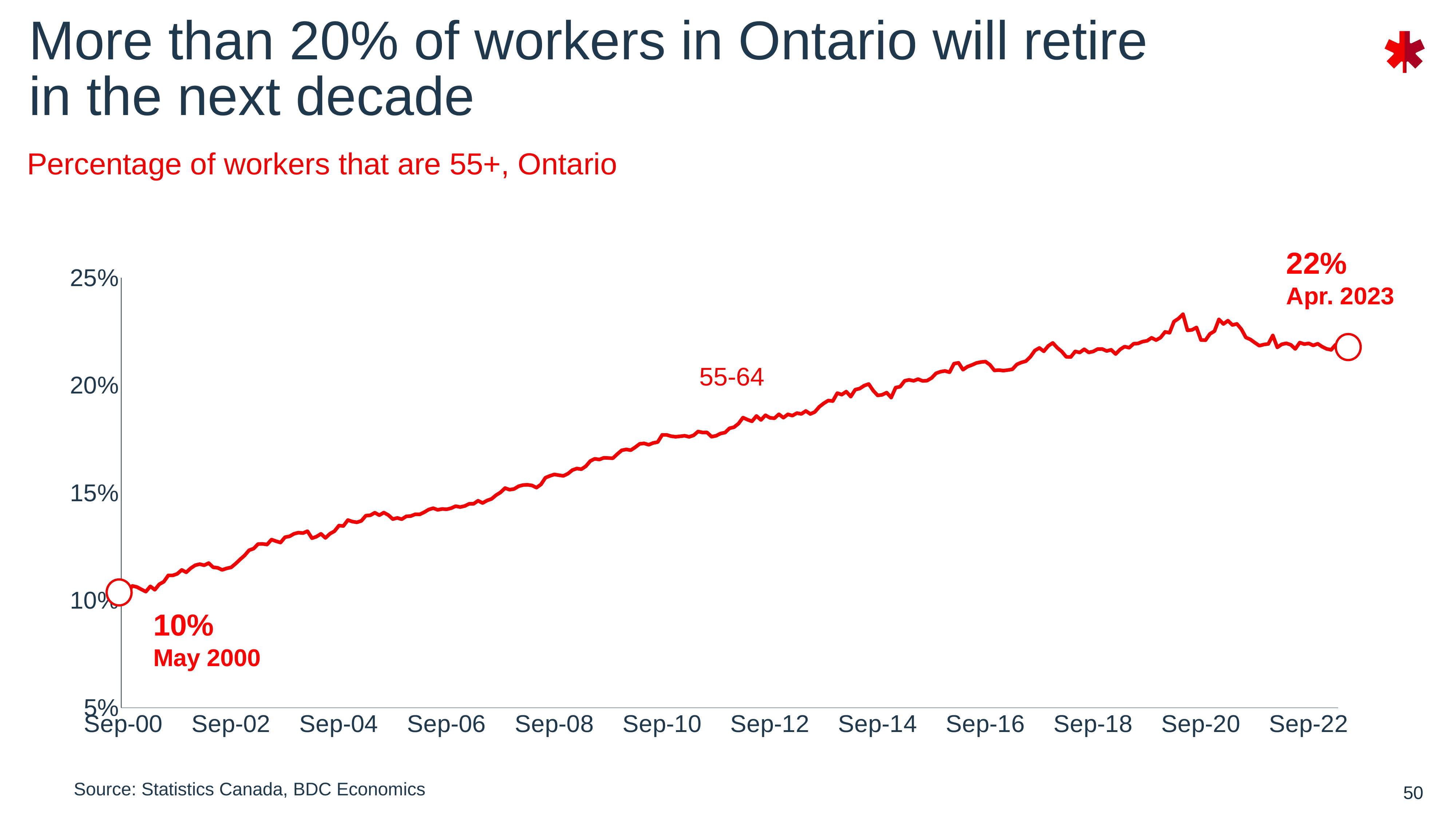
What is the percentage of workers that are 55+ in Ontario in Apr. 2023? 22% Which is larger: the value in May 2000 or the value in Apr. 2023? Apr. 2023 What is the percentage of workers that are 55+ in Ontario in May 2000? 10% Is the value for Sep-20 greater or less than 20%? greater Is the value for Sep-16 greater or less than 20%? greater Is the value for Sep-10 greater or less than 20%? less How many series are plotted on the chart? 1 Does the line generally rise or fall from Sep-00 to Sep-22? rise What is the label shown next to the plotted line? 55-64 What kind of chart is shown on the slide? line chart By how many percentage points did the share of workers aged 55+ change between May 2000 and Apr. 2023? 12 percentage points